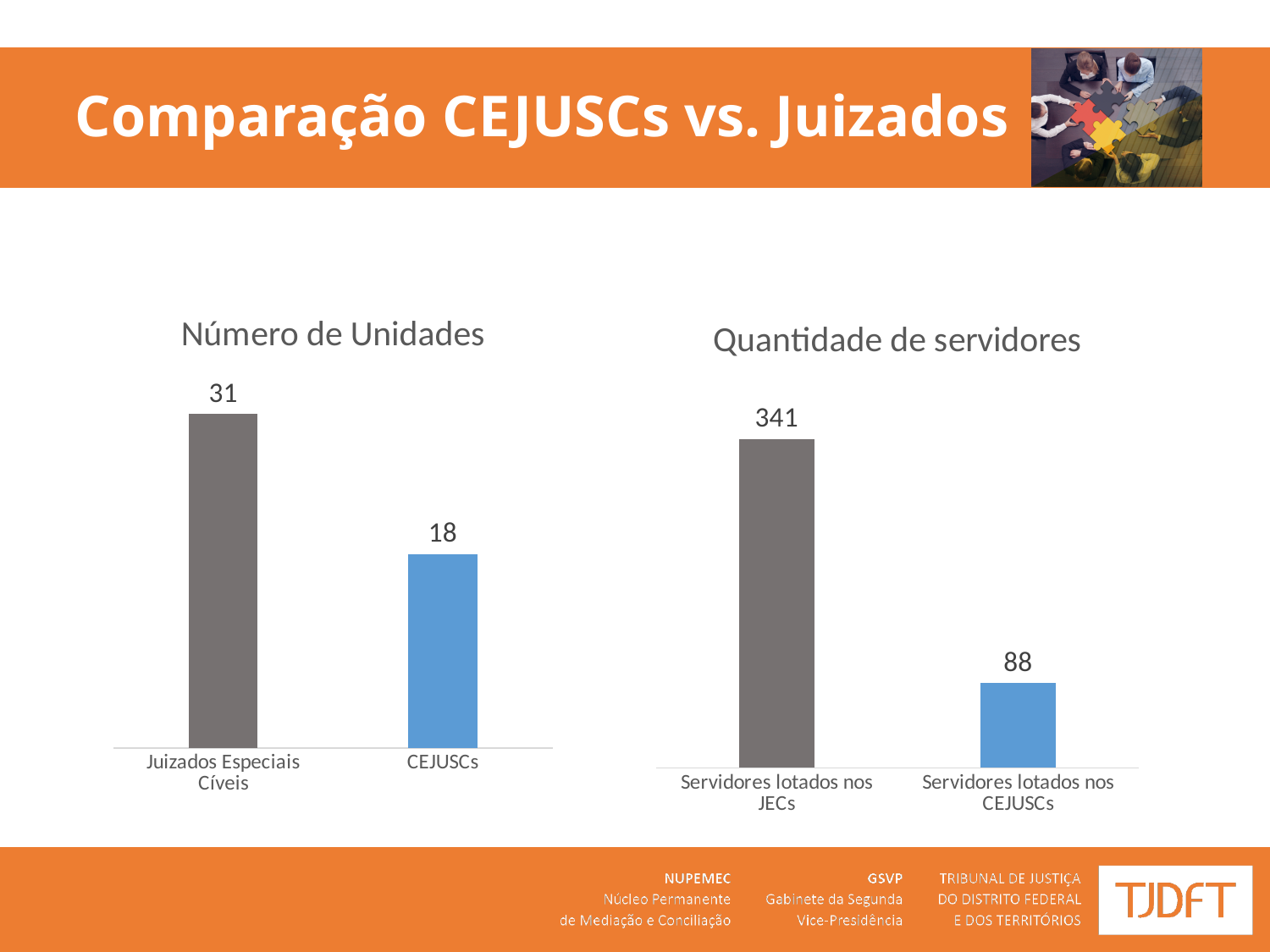
What is the title of the chart on the left side of the slide? Número de Unidades In the 'Quantidade de servidores' chart, what is the value for Servidores lotados nos CEJUSCs? 88 In the 'Quantidade de servidores' chart, which category has the lowest value? Servidores lotados nos CEJUSCs In the 'Número de Unidades' chart, which category has the highest value? Juizados Especiais Cíveis In the 'Número de Unidades' chart, what is the value for CEJUSCs? 18 In the 'Quantidade de servidores' chart, what is the value for Servidores lotados nos JECs? 341 In the 'Número de Unidades' chart, what is the difference between Juizados Especiais Cíveis and CEJUSCs? 13 In the 'Quantidade de servidores' chart, which is larger: Servidores lotados nos JECs or Servidores lotados nos CEJUSCs? Servidores lotados nos JECs In the 'Quantidade de servidores' chart, what is the difference between Servidores lotados nos JECs and Servidores lotados nos CEJUSCs? 253 How many categories are shown in the 'Número de Unidades' chart? 2 What kind of chart is the 'Quantidade de servidores' chart? Bar chart In the 'Número de Unidades' chart, what is the value for Juizados Especiais Cíveis? 31